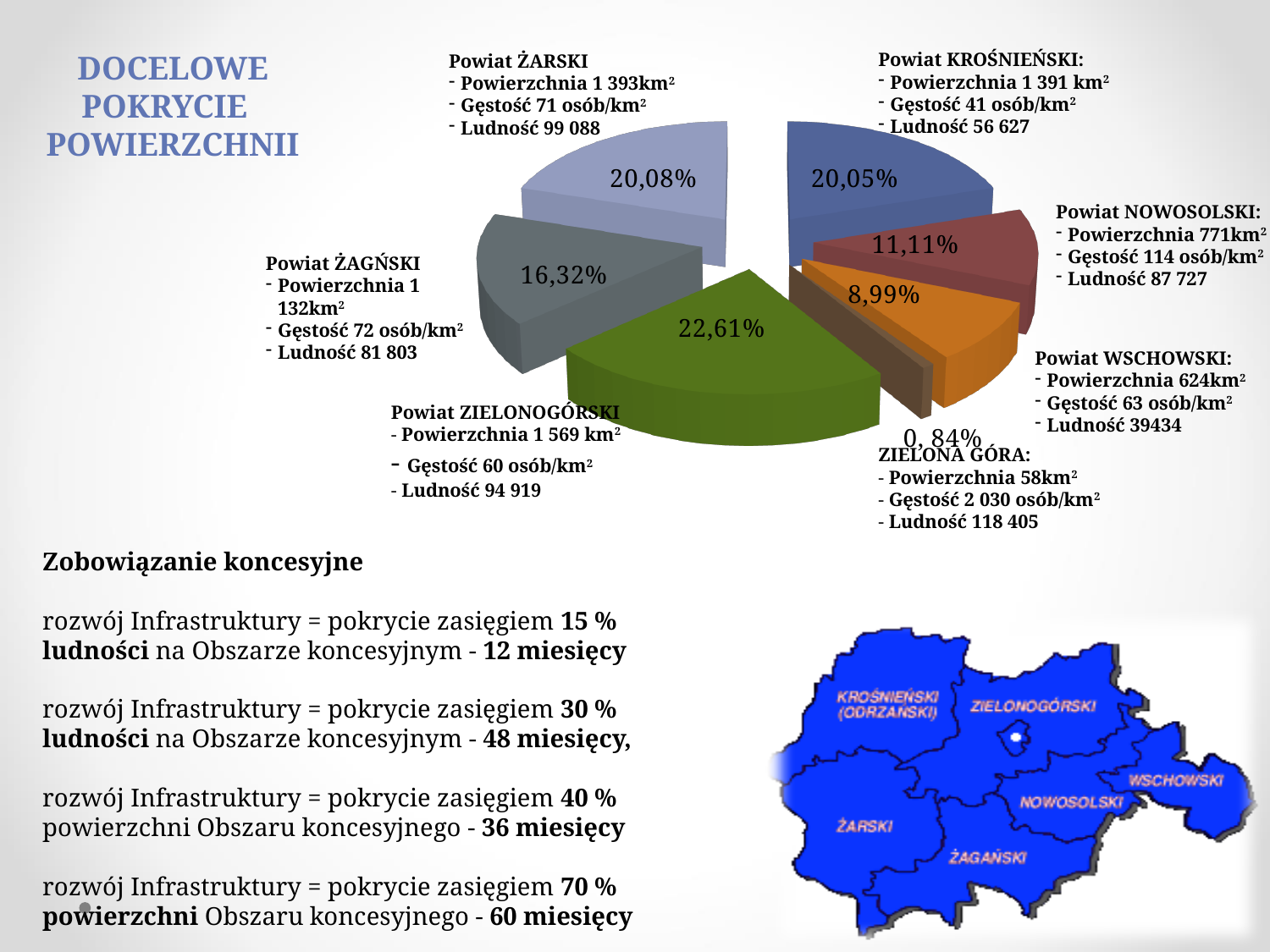
Which slice of the pie chart is the smallest? ZIELONA GÓRA Which slice of the pie chart is the largest? Powiat ZIELONOGÓRSKI What is the difference in percentage points between the Powiat ZIELONOGÓRSKI slice and the Powiat ŻAGAŃSKI slice? 6,29 What share of the pie does Powiat NOWOSOLSKI have? 11,11% What kind of chart is shown on the slide? pie chart How many slices does the pie chart have? 7 What share of the pie does ZIELONA GÓRA have? 0,84% What share of the pie does Powiat ŻAGAŃSKI have? 16,32% What is the title shown at the top left of the slide? DOCELOWE POKRYCIE POWIERZCHNII Which is larger in the pie chart: Powiat ZIELONOGÓRSKI or Powiat ŻAGAŃSKI? Powiat ZIELONOGÓRSKI